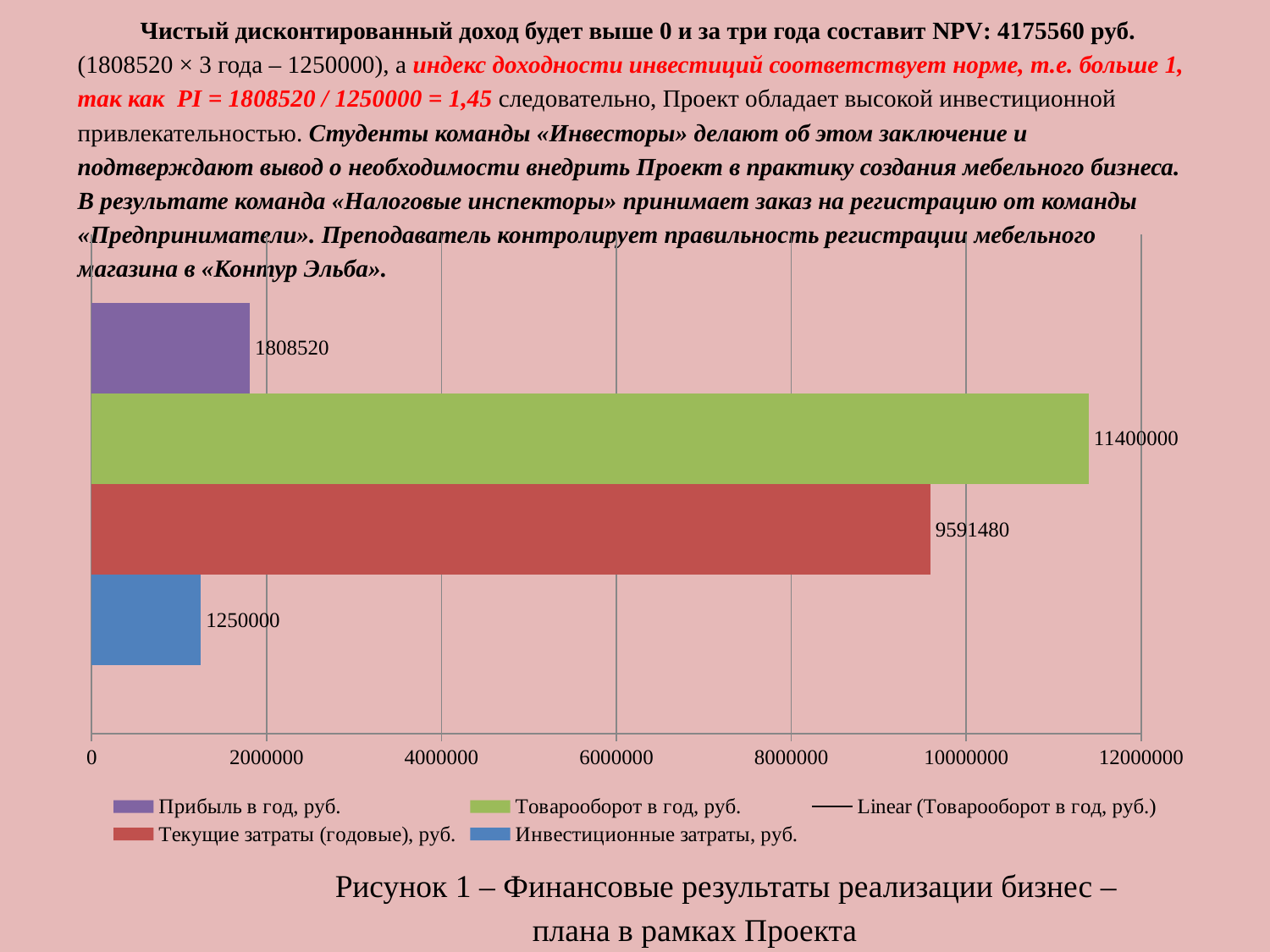
What is the value of the bar for Инвестиционные затраты, руб.? 1250000 What is the value of the bar for Товарооборот в год, руб.? 11400000 Which is larger: Прибыль в год, руб. or Инвестиционные затраты, руб.? Прибыль в год, руб. What is the value of the bar for Текущие затраты (годовые), руб.? 9591480 What is the value of the bar for Прибыль в год, руб.? 1808520 What is the difference between Товарооборот в год, руб. and Текущие затраты (годовые), руб.? 1808520 What type of chart is shown on the slide? bar chart Is the value for Текущие затраты (годовые), руб. greater or less than 10000000? less Which series has the largest bar in the chart? Товарооборот в год, руб. Which series has the smallest bar in the chart? Инвестиционные затраты, руб. How many entries does the chart legend list? 5 What is the difference between Прибыль в год, руб. and Инвестиционные затраты, руб.? 558520